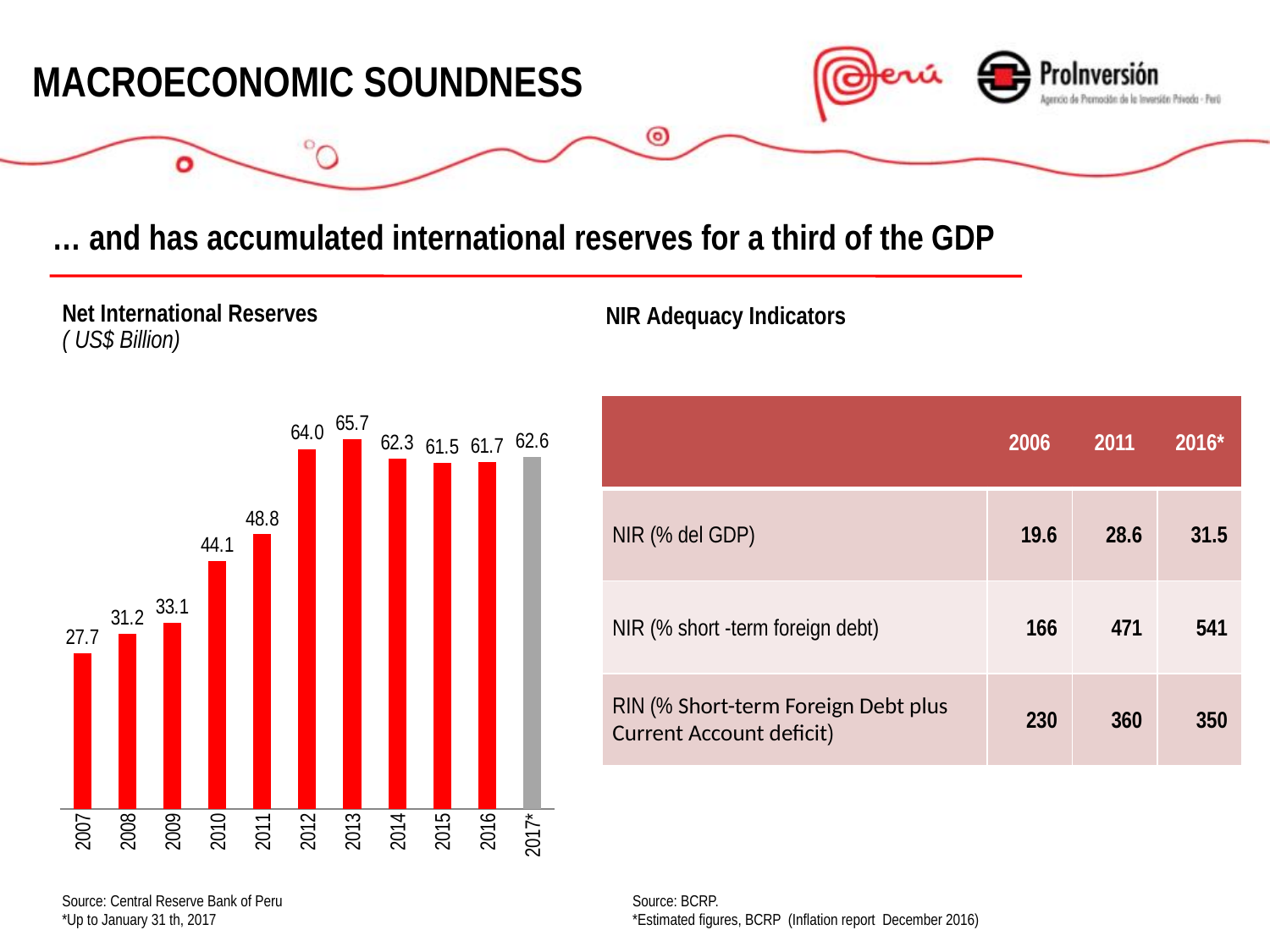
In the Net International Reserves chart, do the values rise or fall from 2007 to 2013? Rise How many years are shown in the Net International Reserves chart? 11 In the Net International Reserves chart, what is the difference between the 2013 and 2007 values? 38.0 In the Net International Reserves chart, what is the value for 2013? 65.7 What kind of chart is the Net International Reserves chart? Bar chart In the Net International Reserves chart, which year has the lowest value? 2007 In the Net International Reserves chart, what unit is given under the title? US$ Billion In the Net International Reserves chart, what is the value for 2007? 27.7 In the Net International Reserves chart, which is larger, the value for 2010 or the value for 2014? 2014 In the Net International Reserves chart, what is the value for 2017*? 62.6 In the Net International Reserves chart, what is the difference between the 2012 and 2011 values? 15.2 In the Net International Reserves chart, which year has the highest value? 2013